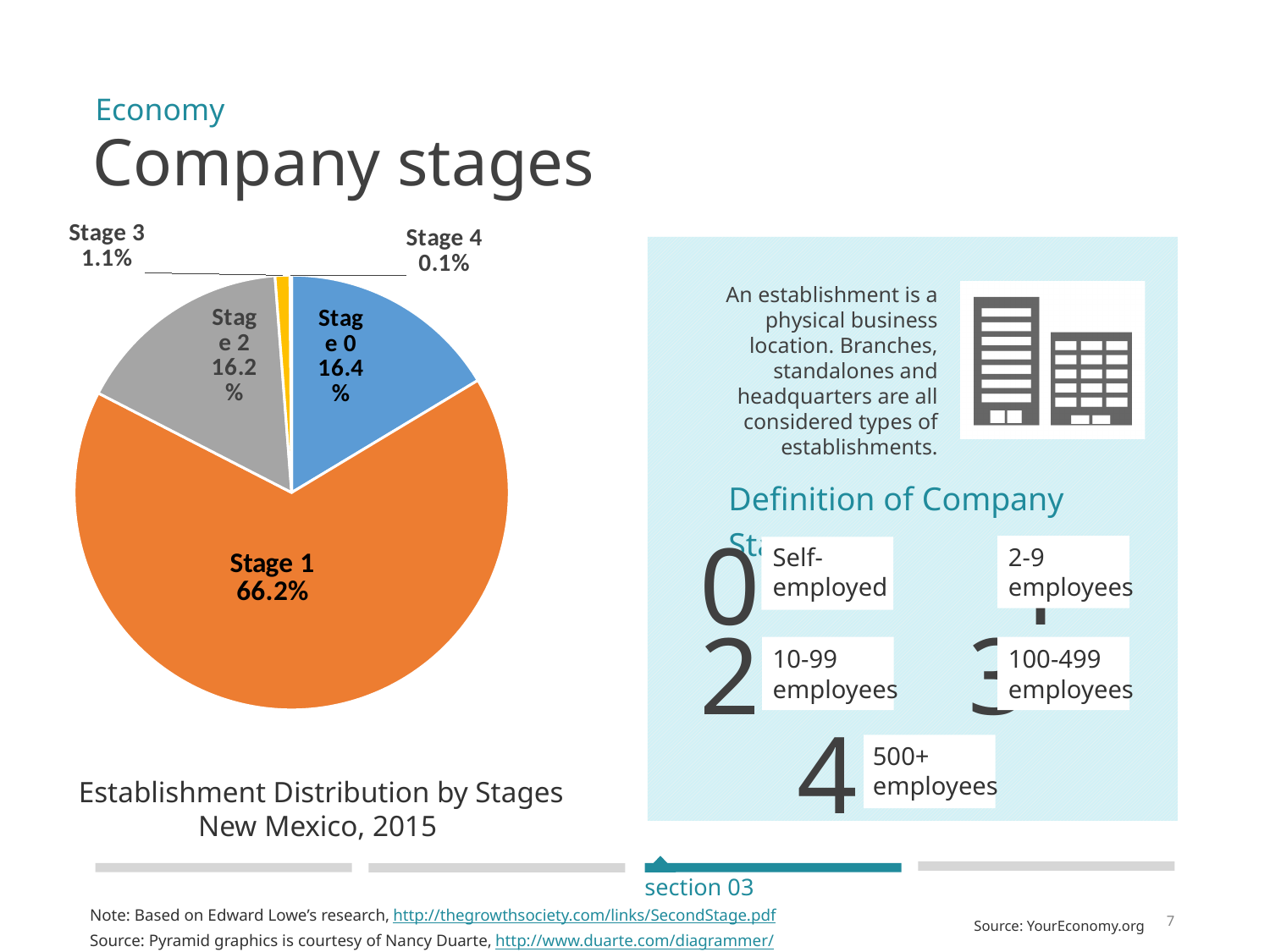
What share of establishments is in Stage 3? 1.1% Which stage has the smallest share of establishments? Stage 4 What is the difference in percentage points between Stage 1 and Stage 0? 49.8 What share of establishments is in Stage 0? 16.4% How many stages are shown in the pie chart? 5 What share of establishments is in Stage 4? 0.1% Which stage has the largest share of establishments? Stage 1 Which is larger, the share for Stage 2 or the share for Stage 3? Stage 2 What is the difference in percentage points between Stage 3 and Stage 4? 1.0 What share of establishments is in Stage 2? 16.2% What share of establishments is in Stage 1? 66.2% What type of chart is used to show the establishment distribution by stages? Pie chart